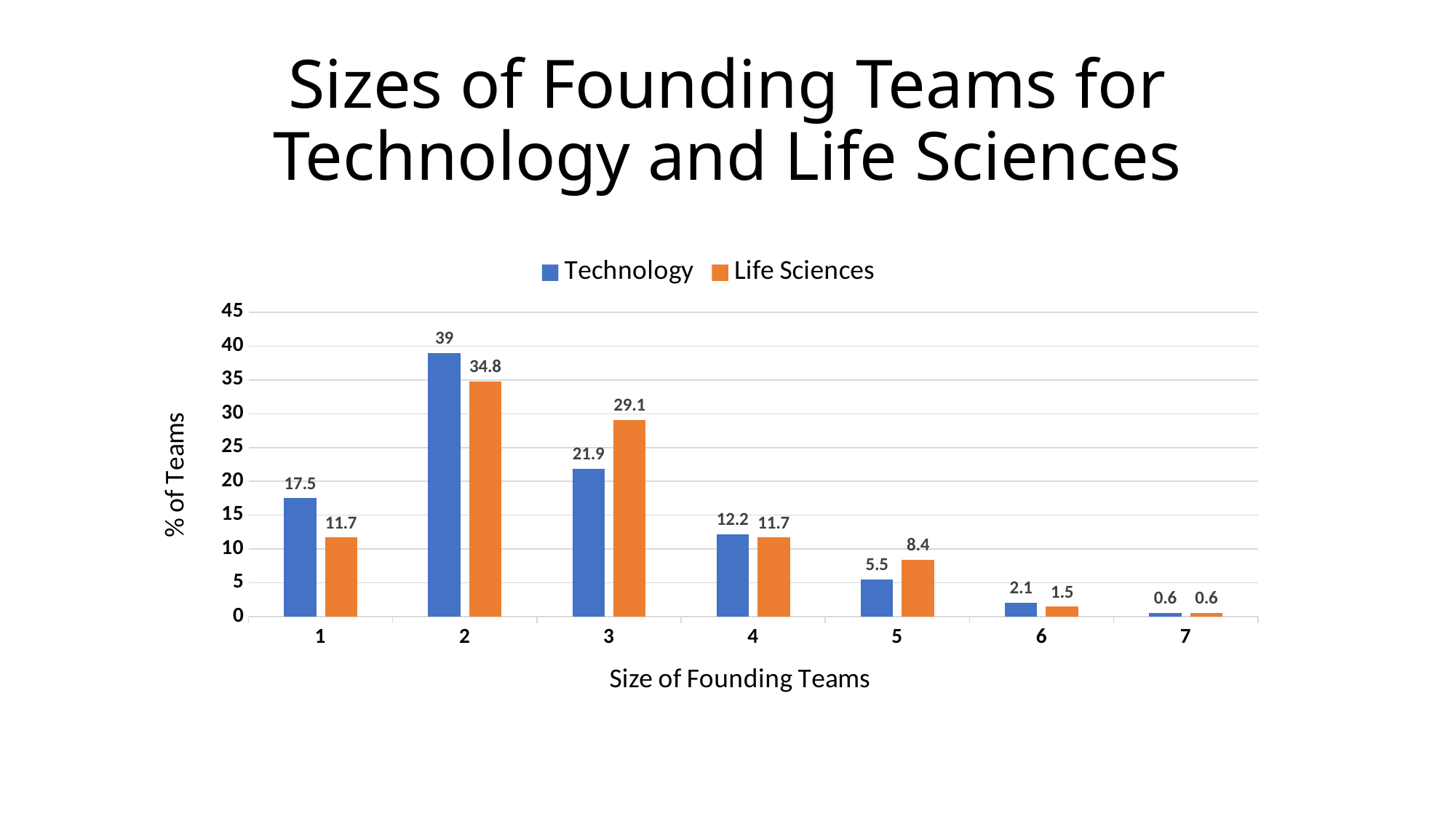
What is the label of the y axis? % of Teams How many series does the legend list? 2 What is the difference between the Technology and Life Sciences values for founding team size 1? 5.8 What kind of chart is shown on the slide? Bar chart For founding team size 3, which series has the larger value, Technology or Life Sciences? Life Sciences What is the Life Sciences value for founding team size 3? 29.1 Do the Technology values rise or fall from founding team size 2 to size 7? Fall What is the Technology value for founding team size 5? 5.5 What is the Technology value for founding team size 2? 39 Which founding team size has the lowest Technology value? 7 Which founding team size has the highest Life Sciences value? 2 How many founding team size categories are shown on the x axis? 7